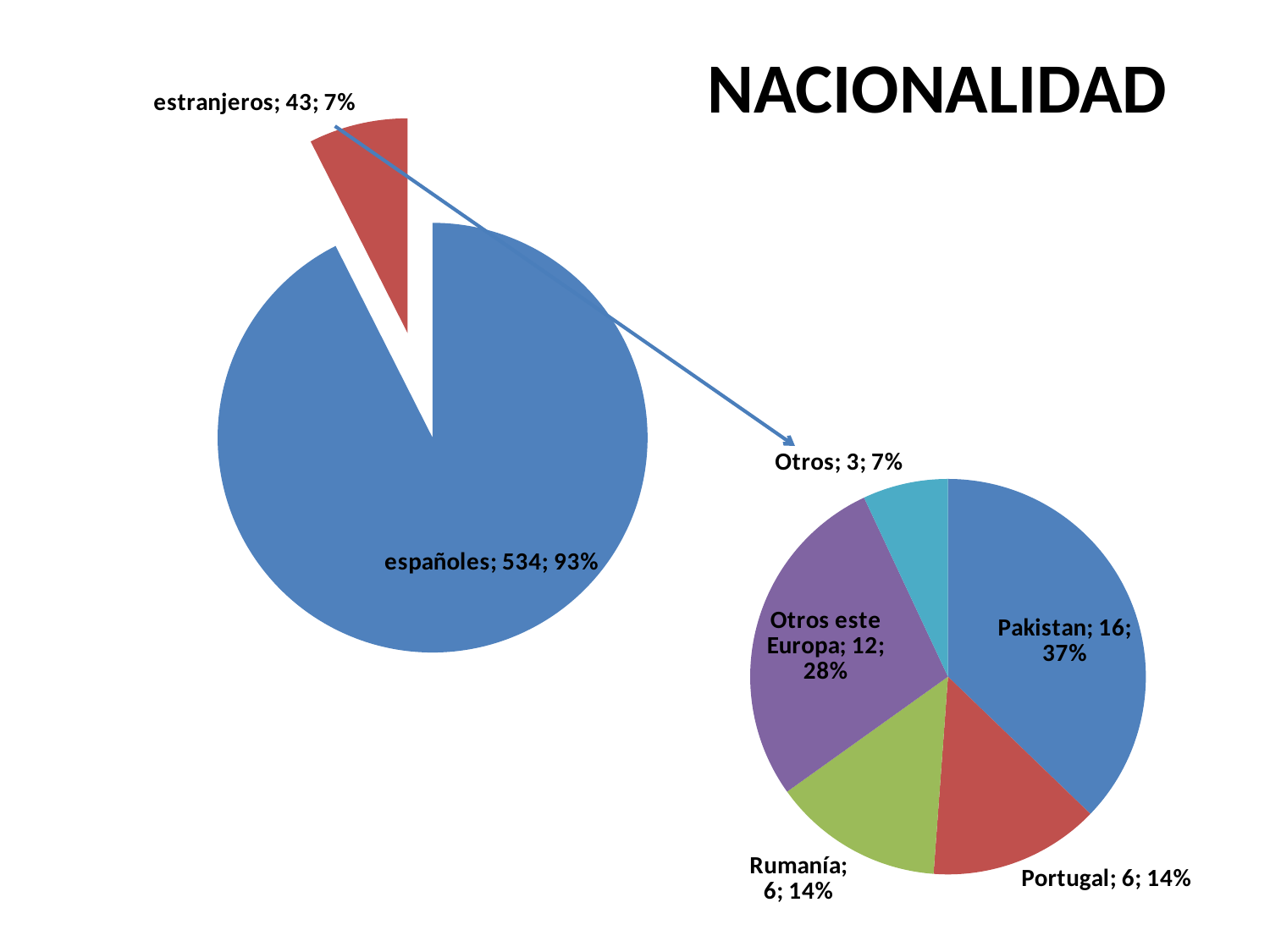
In the left pie chart, how many españoles are there? 534 In the right pie chart, which category has the largest slice? Pakistan In the right pie chart, which is larger, Pakistan or Otros este Europa? Pakistan In the left pie chart, what is the difference between the españoles count and the estranjeros count? 491 In the left pie chart, what percentage share do estranjeros have? 7% In the right pie chart, what percentage share does Portugal have? 14% In the right pie chart, what is the difference between the Pakistan value and the Rumanía value? 10 In the right pie chart, how many slices are there? 5 What is the title shown on the slide? NACIONALIDAD In the right pie chart, what is the value for Otros este Europa? 12 What kind of chart is the chart on the right of the slide? pie chart In the right pie chart, which category has the smallest slice? Otros